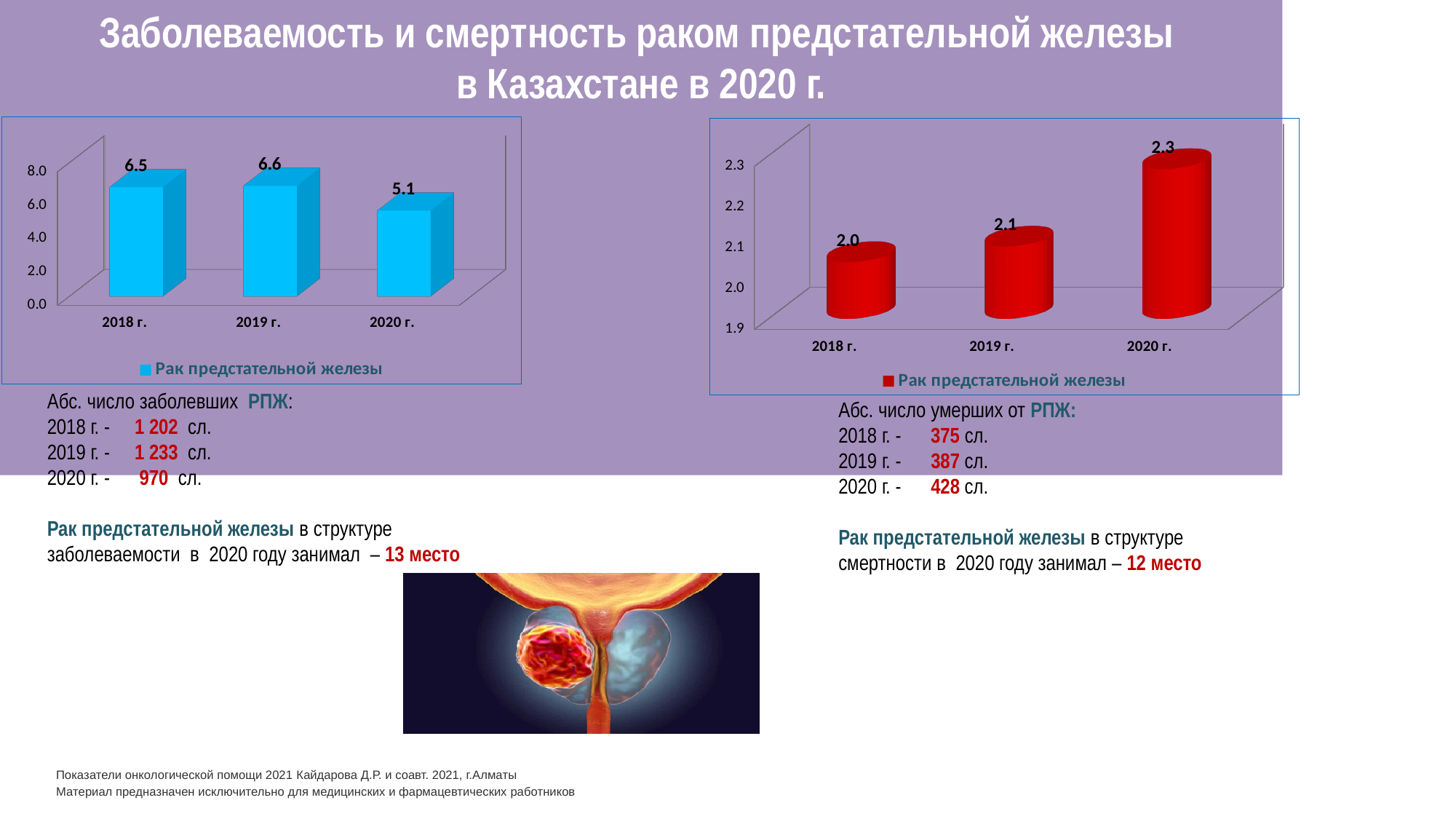
In the left chart, which year has the lowest value? 2020 г. In the right chart, what is the difference between the values for 2020 г. and 2018 г.? 0.3 In the right chart, is the value for 2019 г. larger or smaller than the value for 2020 г.? smaller How many bars are shown in the left chart? 3 What kind of chart is the right chart? bar chart In the right chart, what is the value for 2020 г.? 2.3 In the left chart, what is the value for 2020 г.? 5.1 In the left chart, what is the value for 2018 г.? 6.5 In the right chart, what is the value for 2018 г.? 2.0 In the left chart, which year has the highest value? 2019 г. In the left chart, what is the difference between the values for 2019 г. and 2020 г.? 1.5 In the right chart, which year has the highest value? 2020 г.